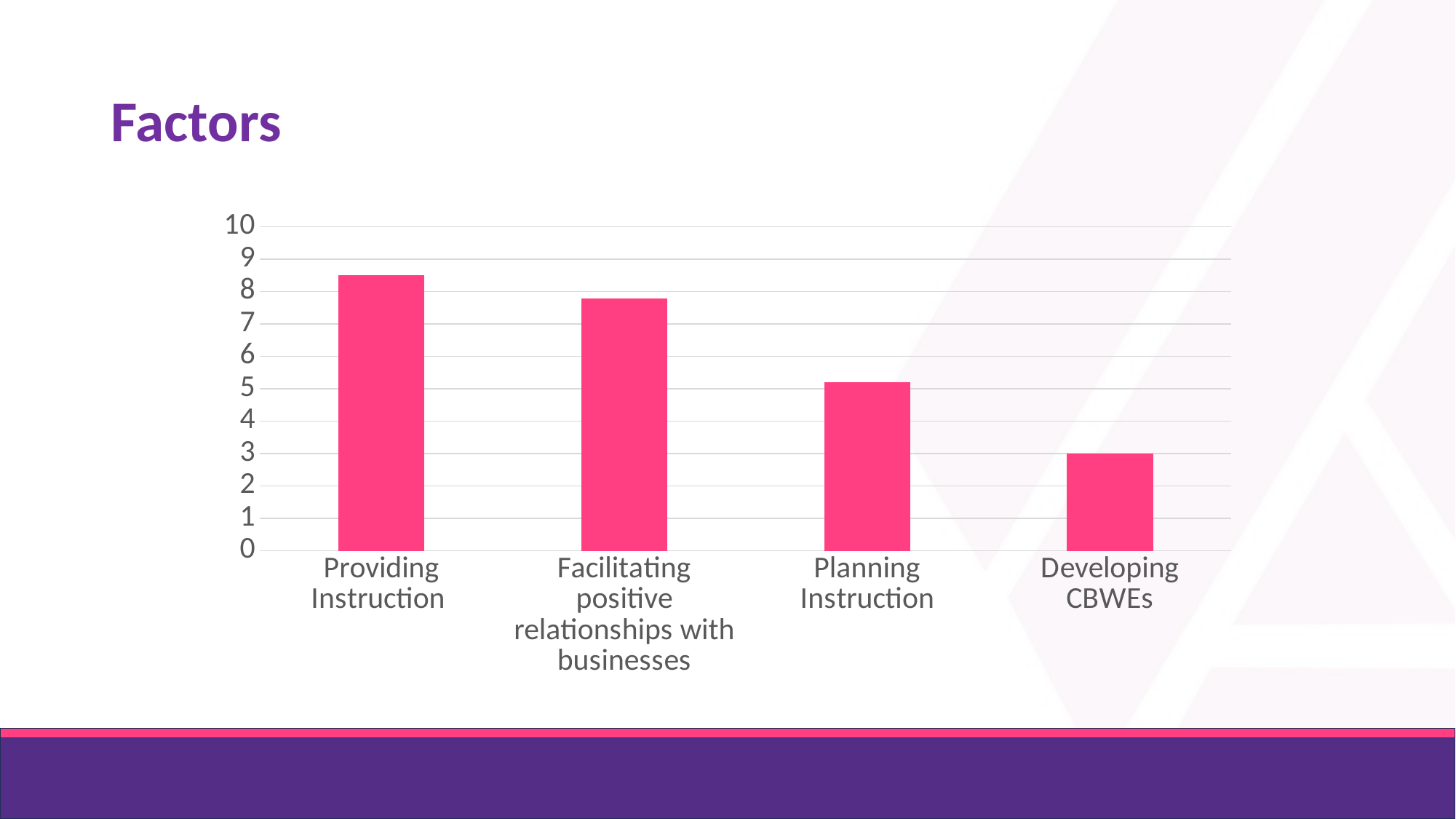
Is the value for Planning Instruction greater or less than 5? greater Which category has the lowest bar? Developing CBWEs Which category has the highest bar? Providing Instruction Which is larger, the value for Planning Instruction or the value for Developing CBWEs? Planning Instruction What is the value for Developing CBWEs? 3 What is the title of the slide containing the chart? Factors Which is larger, the value for Providing Instruction or the value for Facilitating positive relationships with businesses? Providing Instruction Is the value for Providing Instruction greater or less than 8? greater Is the value for Facilitating positive relationships with businesses greater or less than 8? less How many categories are shown on the x axis of the chart? 4 What kind of chart is shown on the slide? bar chart Do the bar values rise or fall from left to right along the x axis? fall